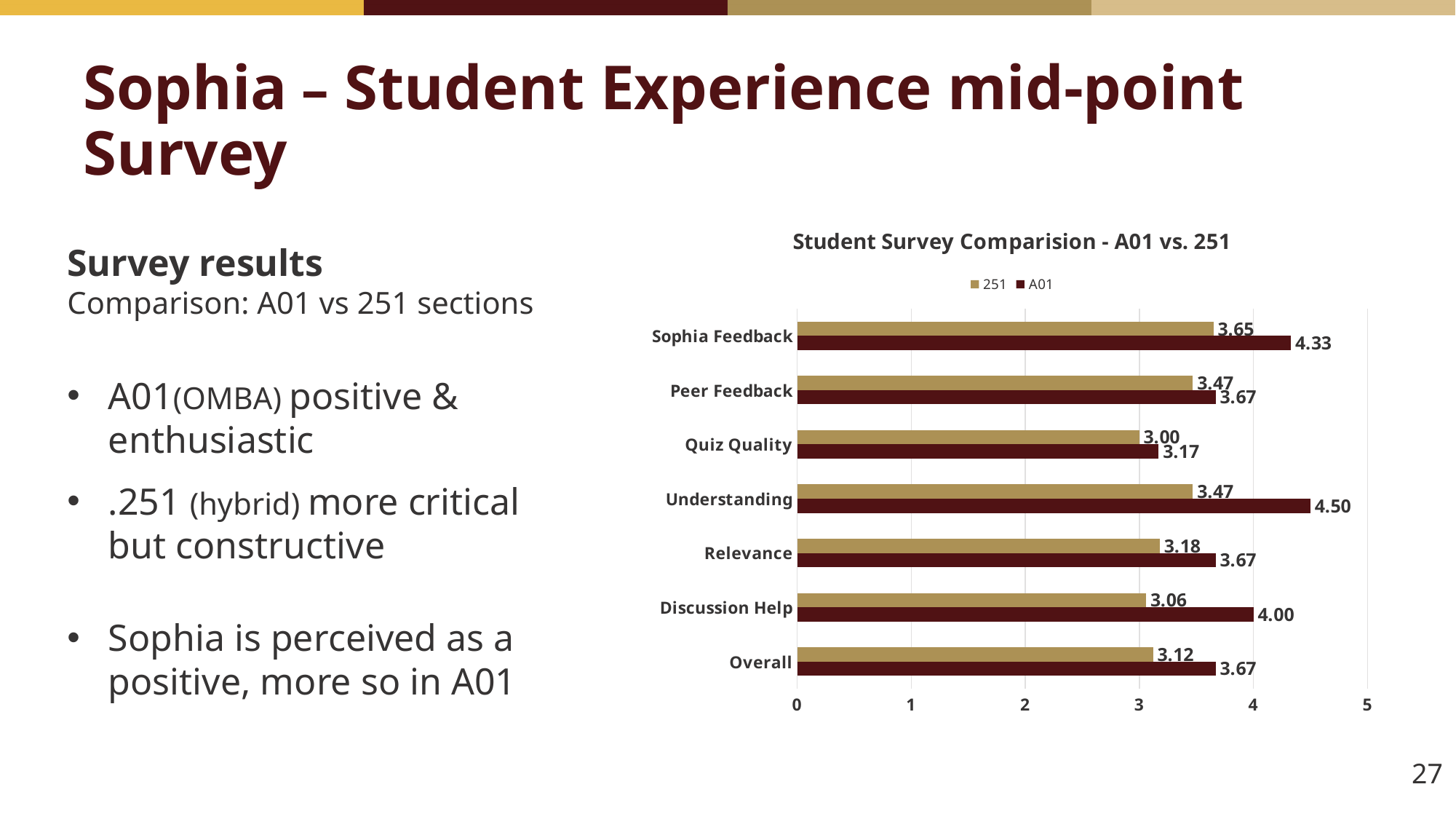
What is the 251 value for Sophia Feedback? 3.65 How many series does the legend list? 2 Which category has the highest A01 value? Understanding Which is larger for Relevance, the A01 value or the 251 value? A01 What is the title of the chart? Student Survey Comparision - A01 vs. 251 How many categories are shown on the chart? 7 What is the 251 value for Discussion Help? 3.06 Is the A01 value for Discussion Help greater or less than 3? greater What is the difference between the A01 and 251 values for Sophia Feedback? 0.68 What kind of chart is shown on the slide? Bar chart What is the A01 value for Understanding? 4.50 Which category has the lowest 251 value? Quiz Quality